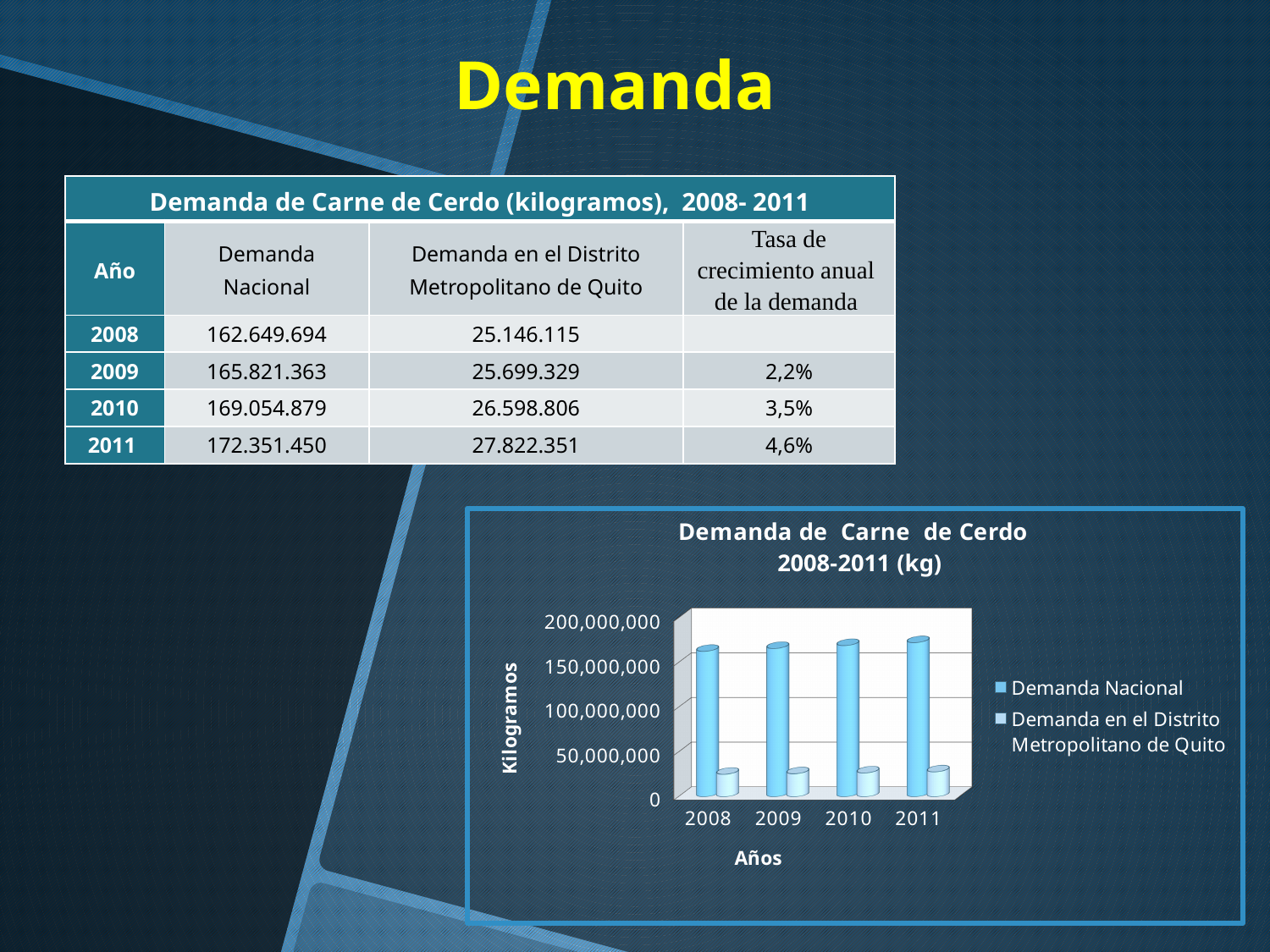
What is the label of the chart's y axis? Kilogramos Is the value for Demanda en el Distrito Metropolitano de Quito in 2008 greater or less than 100,000,000? less Is the value for Demanda Nacional in 2008 greater or less than 150,000,000? greater How many years are shown on the x axis of the chart? 4 What is the title of the chart? Demanda de Carne de Cerdo 2008-2011 (kg) Which series has the higher values across all years in the chart? Demanda Nacional Do the Demanda Nacional values rise or fall from 2008 to 2011? rise In 2010, which is larger: Demanda Nacional or Demanda en el Distrito Metropolitano de Quito? Demanda Nacional What kind of chart is shown on the slide? bar chart Is the value for Demanda en el Distrito Metropolitano de Quito in 2011 greater or less than 50,000,000? less How many series does the chart legend list? 2